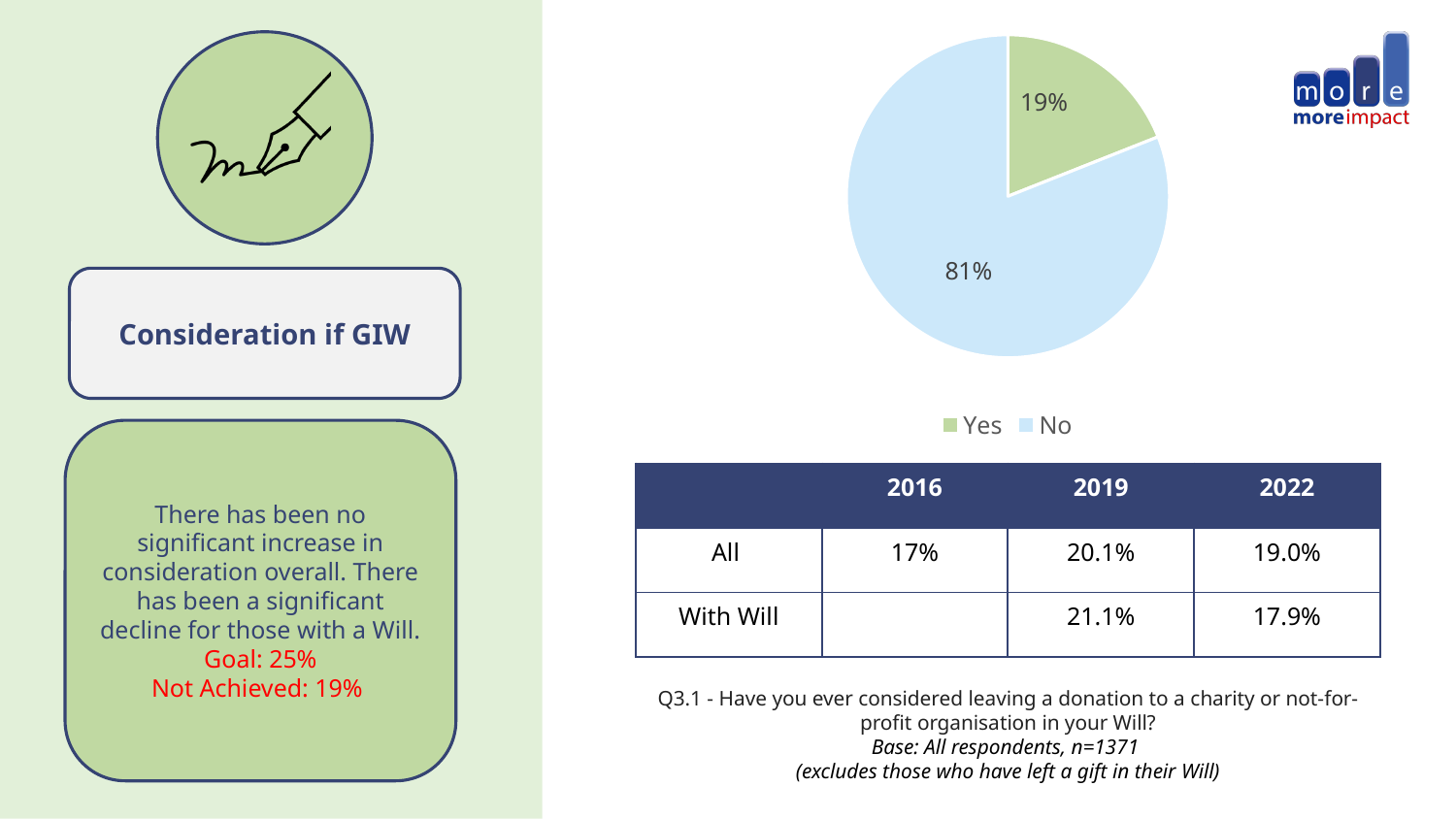
Which colour represents the No slice in the pie chart? light blue Which slice of the pie chart is the largest? No What kind of chart is shown on the slide? pie chart What is the difference in percentage points between the No and Yes slices? 62 Which is larger in the pie chart, the Yes slice or the No slice? No How many slices does the pie chart have? 2 Which slice of the pie chart is the smallest? Yes What percentage of respondents answered Yes in the pie chart? 19% What percentage of respondents answered No in the pie chart? 81% Which colour represents the Yes slice in the pie chart? green How many entries does the pie chart legend list? 2 What share of the pie does the Yes slice represent? 19%